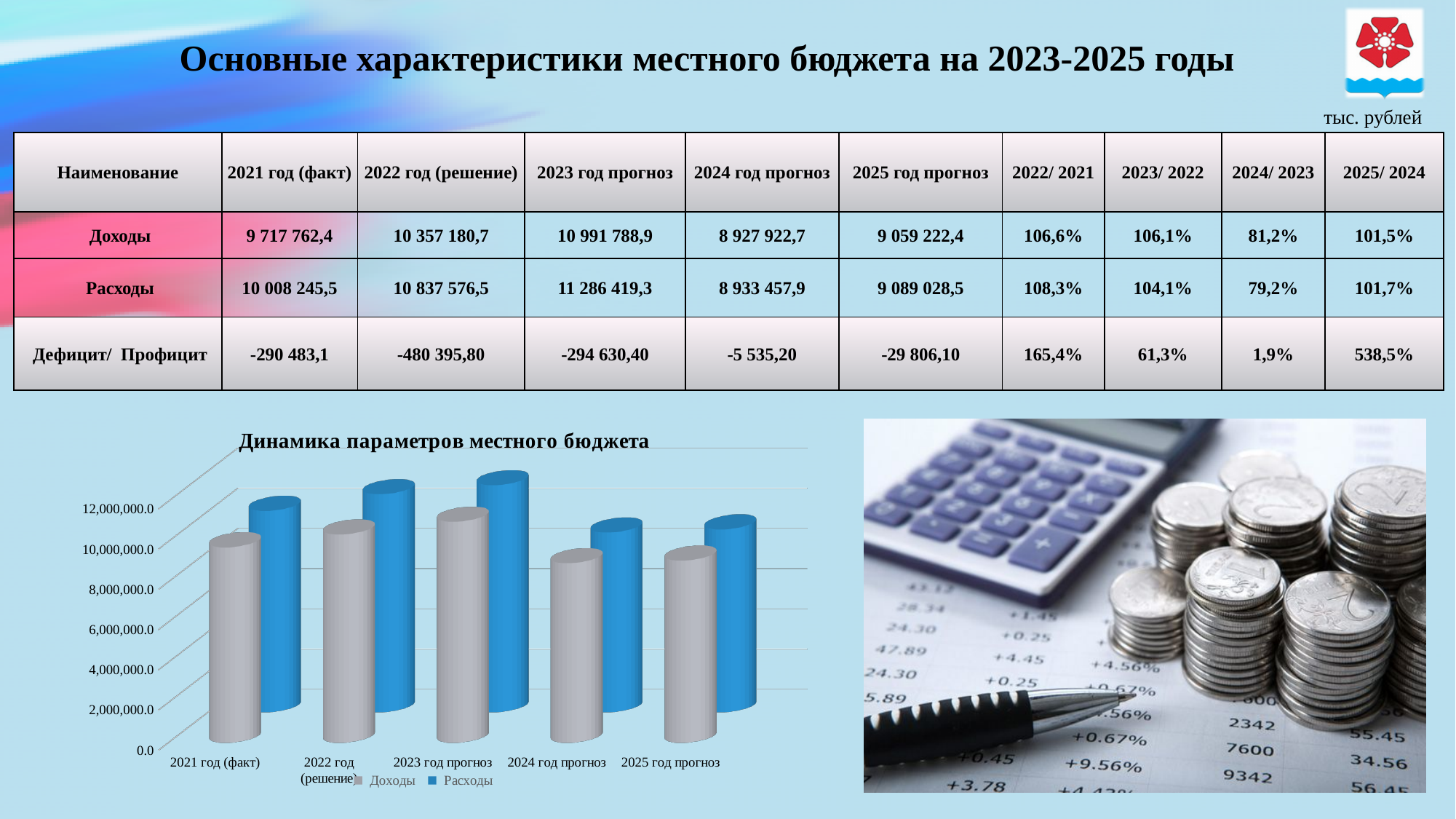
In the chart "Динамика параметров местного бюджета", which year has the highest value for Расходы? 2023 год прогноз In the chart "Динамика параметров местного бюджета", which year has the highest value for Доходы? 2023 год прогноз In the chart "Динамика параметров местного бюджета", which is larger for 2022 год (решение): Доходы or Расходы? Расходы In the chart "Динамика параметров местного бюджета", is the value for Расходы in 2021 год (факт) greater or less than 12,000,000.0? less In the chart "Динамика параметров местного бюджета", do the Доходы values rise or fall from 2021 год (факт) to 2023 год прогноз? rise In the chart "Динамика параметров местного бюджета", which colour represents the Расходы series? blue How many series does the legend of the chart "Динамика параметров местного бюджета" list? 2 In the chart "Динамика параметров местного бюджета", is the value for Расходы in 2023 год прогноз greater or less than 10,000,000.0? greater How many categories (years) are shown on the x axis of the chart "Динамика параметров местного бюджета"? 5 What kind of chart is "Динамика параметров местного бюджета"? bar chart In the chart "Динамика параметров местного бюджета", which is larger for Доходы: 2021 год (факт) or 2023 год прогноз? 2023 год прогноз In the chart "Динамика параметров местного бюджета", is the value for Доходы in 2024 год прогноз greater or less than 8,000,000.0? greater